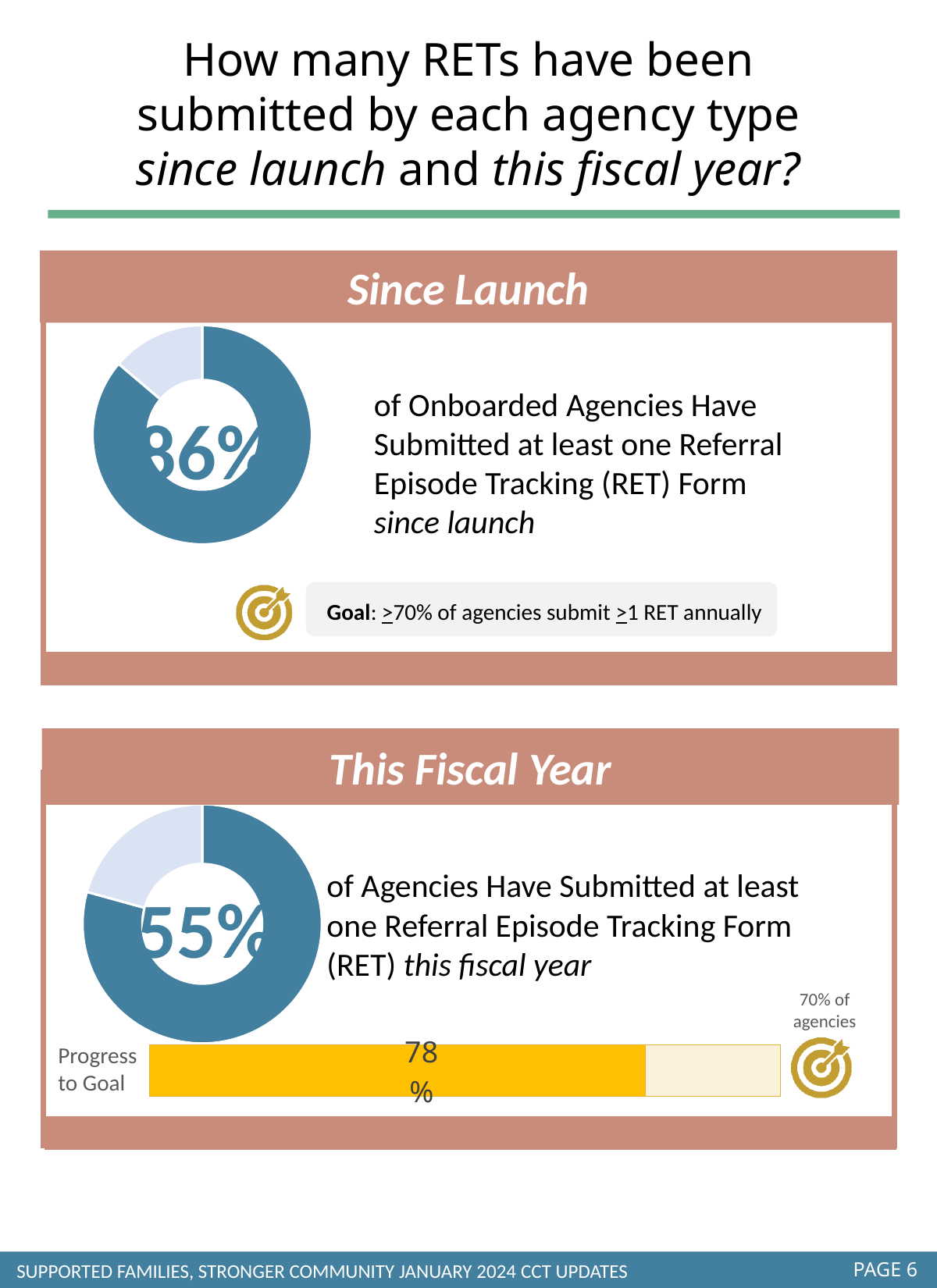
In the Since Launch donut chart, what share of the donut is the lighter (remaining) slice? 14% What kind of chart is used in the Since Launch section to show the 86% figure? Donut (pie) chart What goal is stated in the Since Launch section? ≥70% of agencies submit ≥1 RET annually Which is larger: the percentage of agencies that submitted a RET since launch, or the percentage this fiscal year? Since launch (86%) What is the difference in percentage points between the Since Launch value and the This Fiscal Year value? 31 percentage points Is the Since Launch value of 86% greater or less than the 70% goal shown on the slide? greater Is the This Fiscal Year value of 55% greater or less than the 70% goal shown on the slide? less How many donut charts are shown on the slide? 2 In the This Fiscal Year donut chart, what percentage of agencies have submitted at least one RET form this fiscal year? 55% What value is shown on the Progress to Goal bar in the This Fiscal Year section? 78% In the Since Launch donut chart, what percentage of onboarded agencies have submitted at least one RET form since launch? 86%